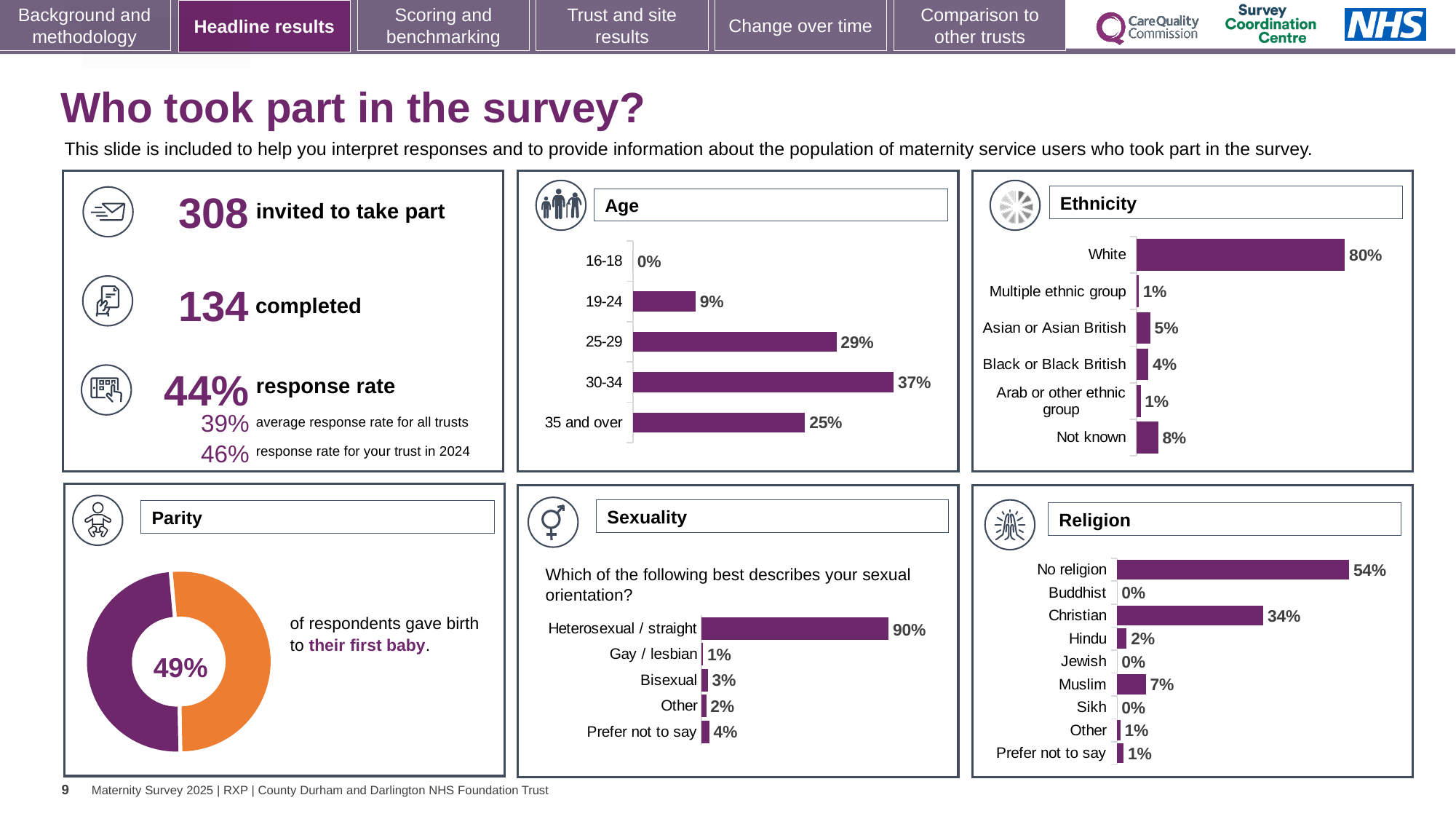
In the Ethnicity chart, what percentage of respondents were White? 80% In the Age chart, which age group has the highest percentage? 30-34 In the Parity chart, what percentage of respondents gave birth to their first baby? 49% In the Age chart, how many age categories are shown? 5 In the Religion chart, which category has the highest percentage? No religion In the Religion chart, what is the difference between No religion and Christian? 20% What kind of chart is used in the Parity panel? Doughnut chart In the Age chart, what percentage of respondents were aged 30-34? 37% In the Sexuality chart, what percentage of respondents answered Prefer not to say? 4% In the Ethnicity chart, which is larger: Not known or Asian or Asian British? Not known In the Ethnicity chart, what is the difference between the percentages for Asian or Asian British and Black or Black British? 1% In the Religion chart, what percentage of respondents were Christian? 34%